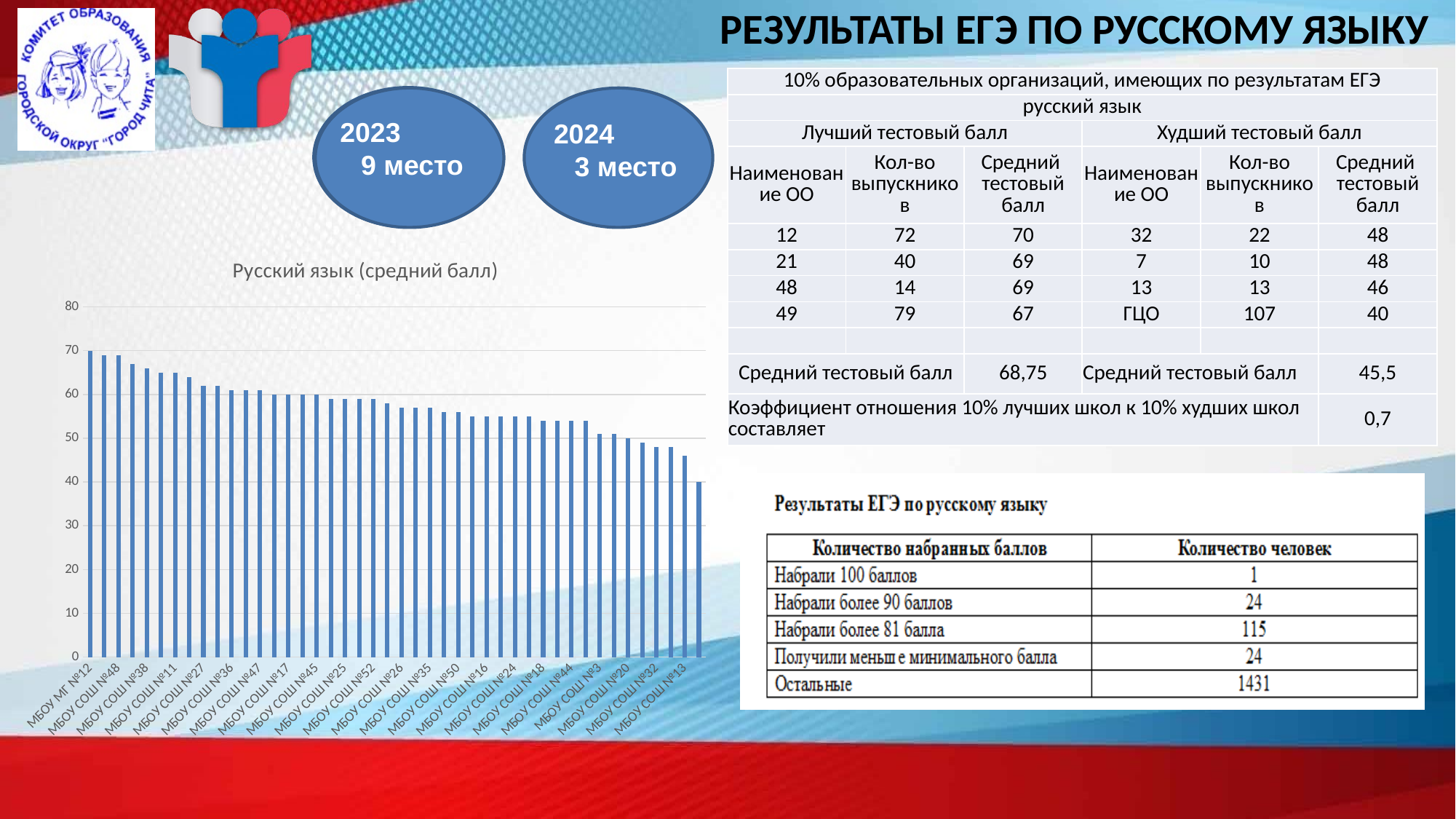
Which is larger, the value for МБОУ СОШ №38 or the value for МБОУ СОШ №32? МБОУ СОШ №38 Is the value for МБОУ МГ №12 greater or less than 60? greater What is the highest value shown on the vertical axis of the chart? 80 Do the values in the chart rise or fall from left to right along the x axis? fall Is the value for МБОУ СОШ №44 greater or less than 60? less What kind of chart is shown on the slide? bar chart What is the title of the chart? Русский язык (средний балл) Which is larger, the value for МБОУ МГ №12 or the value for МБОУ СОШ №13? МБОУ МГ №12 Is the value for МБОУ СОШ №13 greater or less than 50? less